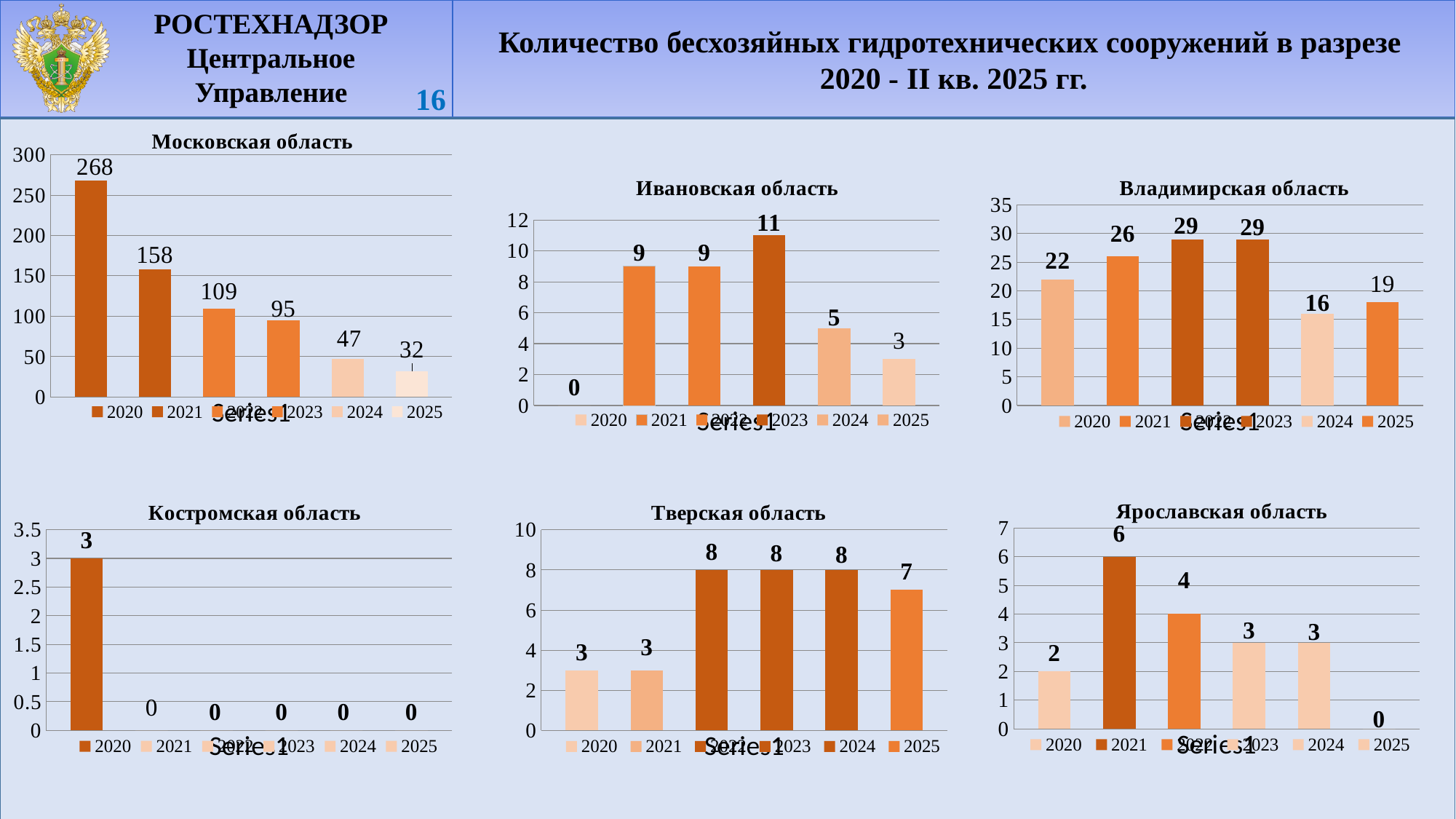
In the Московская область chart, what is the difference between the 2020 and 2021 values? 110 In the Владимирская область chart, what is the value for 2024? 16 In the Ярославская область chart, which year has the lowest value? 2025 In the Московская область chart, what is the value for 2020? 268 In the Московская область chart, do the values rise or fall from 2020 to 2025? fall What type of chart is the Тверская область chart? bar chart In the Ивановская область chart, what is the value for 2020? 0 In the Владимирская область chart, which is larger, the value for 2021 or the value for 2025? 2021 In the Тверская область chart, what is the value for 2025? 7 In the Костромская область chart, what is the value for 2020? 3 In the Ивановская область chart, which year has the highest value? 2023